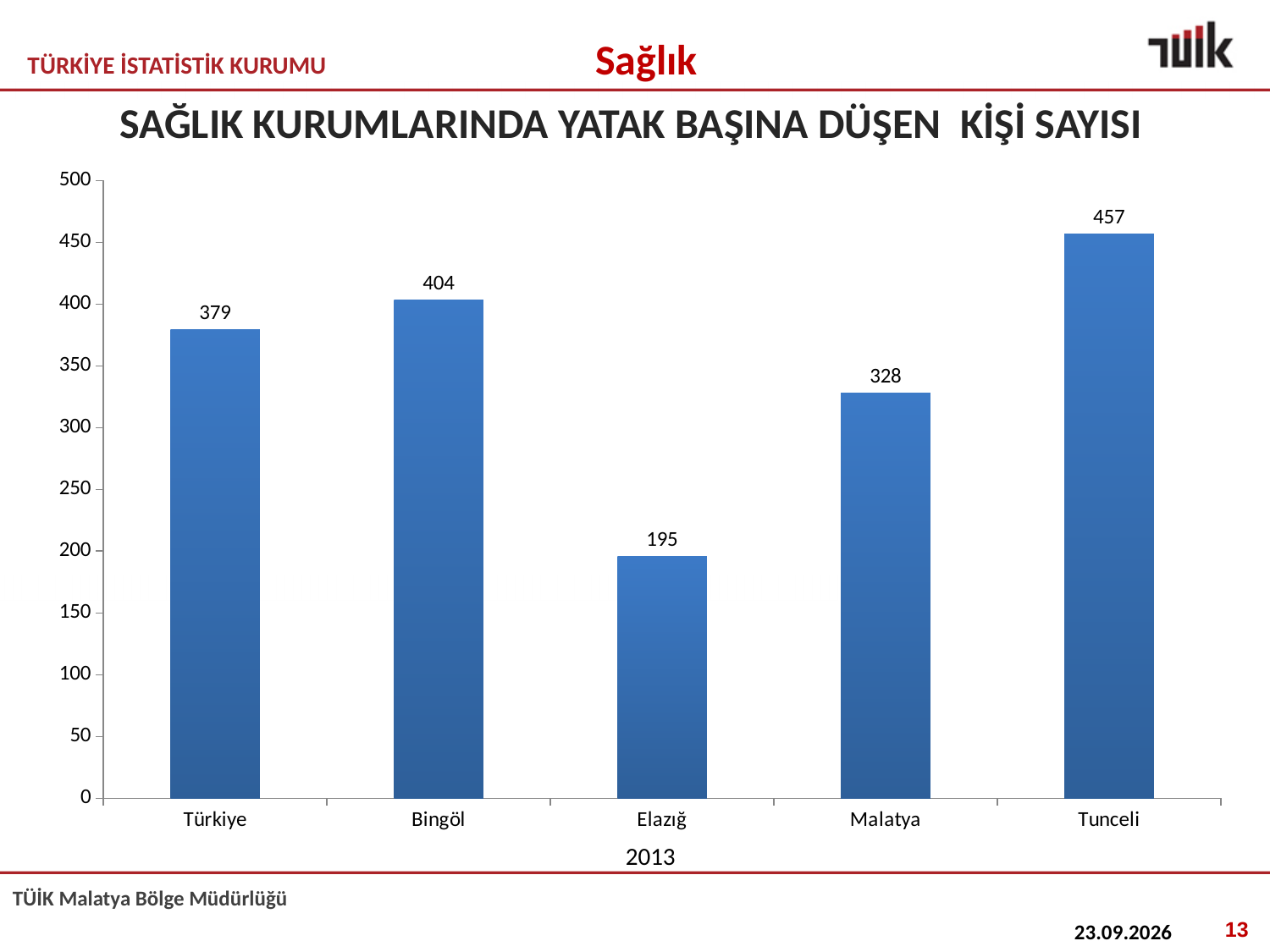
What is the difference between the values for Tunceli and Türkiye? 78 What is the difference between the values for Bingöl and Malatya? 76 Which category has the lowest value? Elazığ What is the value for Türkiye? 379 Which is larger, the value for Bingöl or the value for Türkiye? Bingöl Which category has the highest value? Tunceli Is the value for Malatya greater or less than 350? less What is the value for Elazığ? 195 What year is shown below the x axis labels? 2013 What kind of chart is shown on the slide? bar chart How many categories are shown on the x axis? 5 What is the value for Tunceli? 457